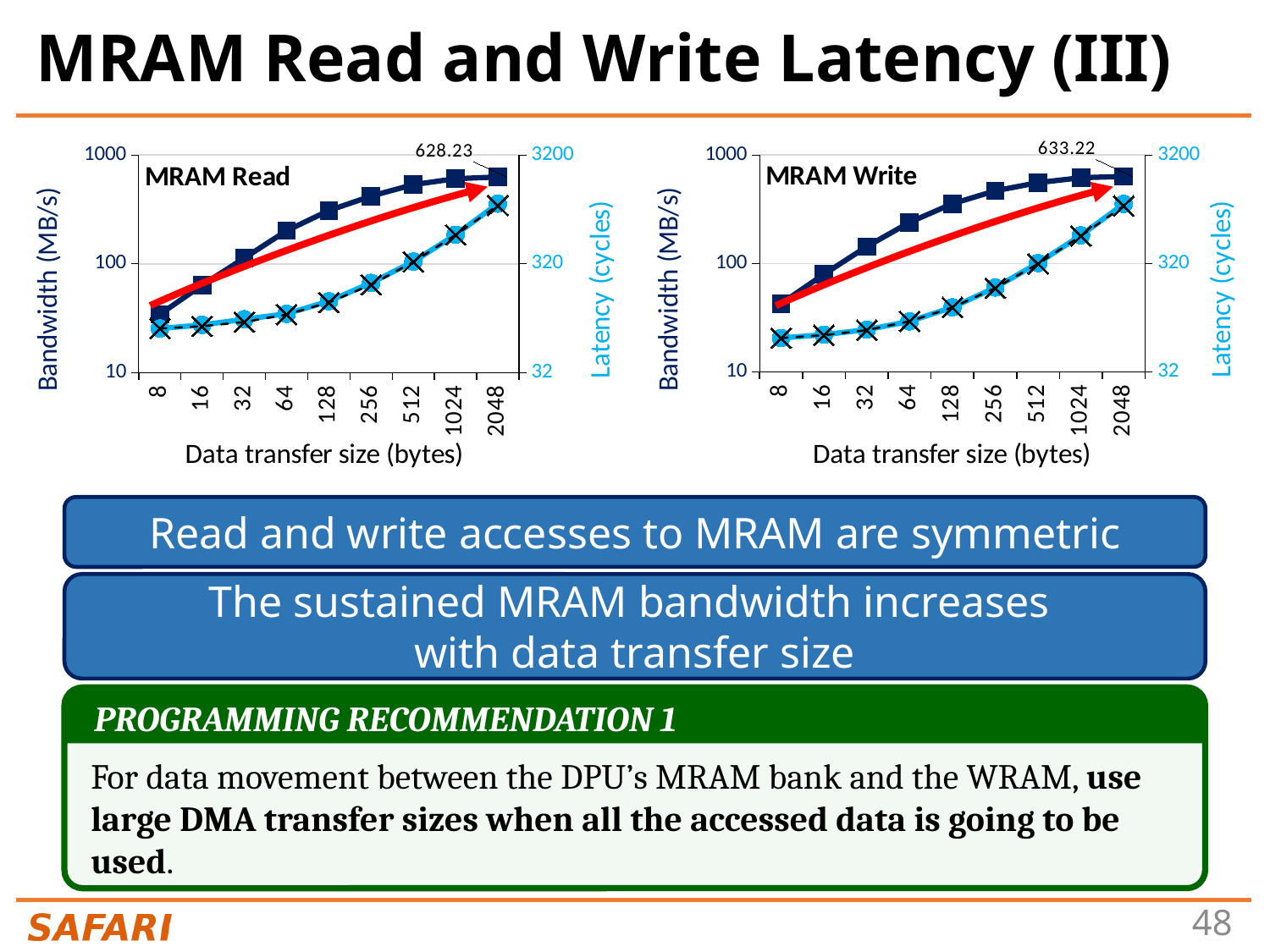
What is the difference between the labeled bandwidth at 2048 bytes in the MRAM Write chart and in the MRAM Read chart? 4.99 In the MRAM Write chart, is the latency at a data transfer size of 8 bytes greater or less than 320 cycles? less In the MRAM Read chart, what is the bandwidth value labeled at a data transfer size of 2048 bytes? 628.23 What is the x-axis title of the MRAM Read chart? Data transfer size (bytes) In the MRAM Read chart, is the bandwidth at a data transfer size of 8 bytes greater or less than 100 MB/s? less In the MRAM Write chart, does bandwidth rise or fall as the data transfer size increases? Rises In the MRAM Write chart, what is the bandwidth value labeled at a data transfer size of 2048 bytes? 633.22 In the MRAM Read chart, which data transfer size has the highest bandwidth? 2048 What kind of chart is the MRAM Read chart? Line chart In the MRAM Write chart, which data transfer size has the lowest bandwidth? 8 How many data transfer sizes are plotted along the x axis of the MRAM Read chart? 9 Which chart shows the higher labeled bandwidth at 2048 bytes, MRAM Read or MRAM Write? MRAM Write